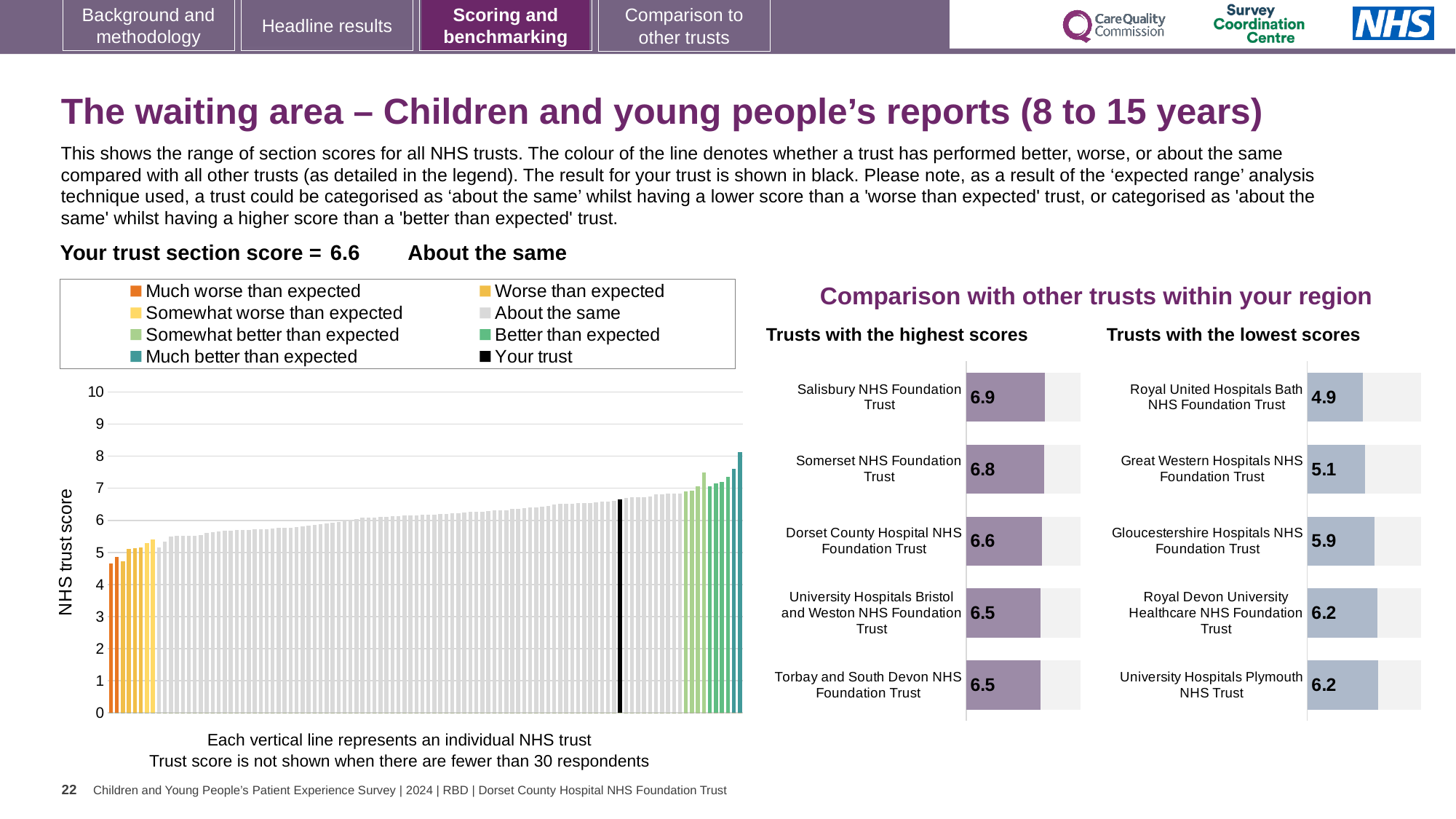
In the 'NHS trust score' chart on the left, is the value for the black 'Your trust' bar greater or less than 6? greater In the 'Trusts with the highest scores' chart, what is the score for Dorset County Hospital NHS Foundation Trust? 6.6 In the 'Trusts with the highest scores' chart, what is the score for Salisbury NHS Foundation Trust? 6.9 In the 'Trusts with the lowest scores' chart, which has the higher score: Royal United Hospitals Bath NHS Foundation Trust or Gloucestershire Hospitals NHS Foundation Trust? Gloucestershire Hospitals NHS Foundation Trust In the 'Trusts with the highest scores' chart, which trust has the highest score? Salisbury NHS Foundation Trust How many entries does the legend of the 'NHS trust score' chart on the left list? 8 In the 'Trusts with the lowest scores' chart, what is the difference between the scores of Gloucestershire Hospitals NHS Foundation Trust and Great Western Hospitals NHS Foundation Trust? 0.8 In the 'Trusts with the highest scores' chart, what is the difference between the scores of Salisbury NHS Foundation Trust and Somerset NHS Foundation Trust? 0.1 In the 'Trusts with the lowest scores' chart, what is the score for Great Western Hospitals NHS Foundation Trust? 5.1 How many trusts are listed in the 'Trusts with the lowest scores' chart? 5 In the 'Trusts with the lowest scores' chart, which trust has the lowest score? Royal United Hospitals Bath NHS Foundation Trust In the 'NHS trust score' chart on the left, do the bar values rise or fall from left to right? rise